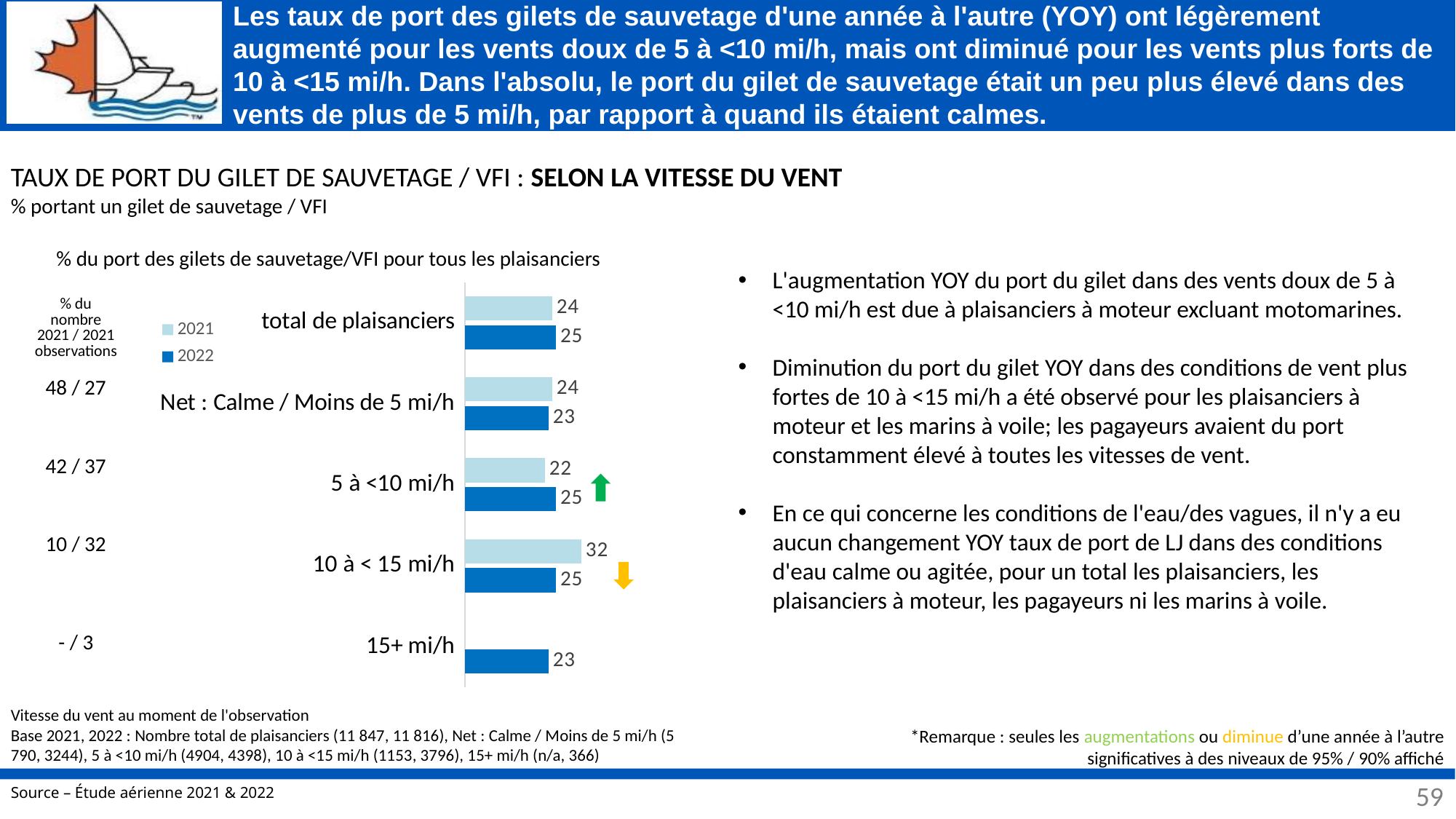
What is the difference between the 2022 and 2021 values for "5 à <10 mi/h"? 3 How many series does the legend list? 2 What is the 2021 value for "10 à < 15 mi/h"? 32 What is the 2022 value for "15+ mi/h"? 23 What is the 2022 value for "5 à <10 mi/h"? 25 What kind of chart is shown on the slide? Bar chart For "Net : Calme / Moins de 5 mi/h", which year has the larger value, 2021 or 2022? 2021 What is the difference between the 2021 and 2022 values for "10 à < 15 mi/h"? 7 Which category has the lowest 2021 value? 5 à <10 mi/h What is the 2021 value for "total de plaisanciers"? 24 Which category has the highest 2021 value? 10 à < 15 mi/h How many categories are shown on the chart? 5